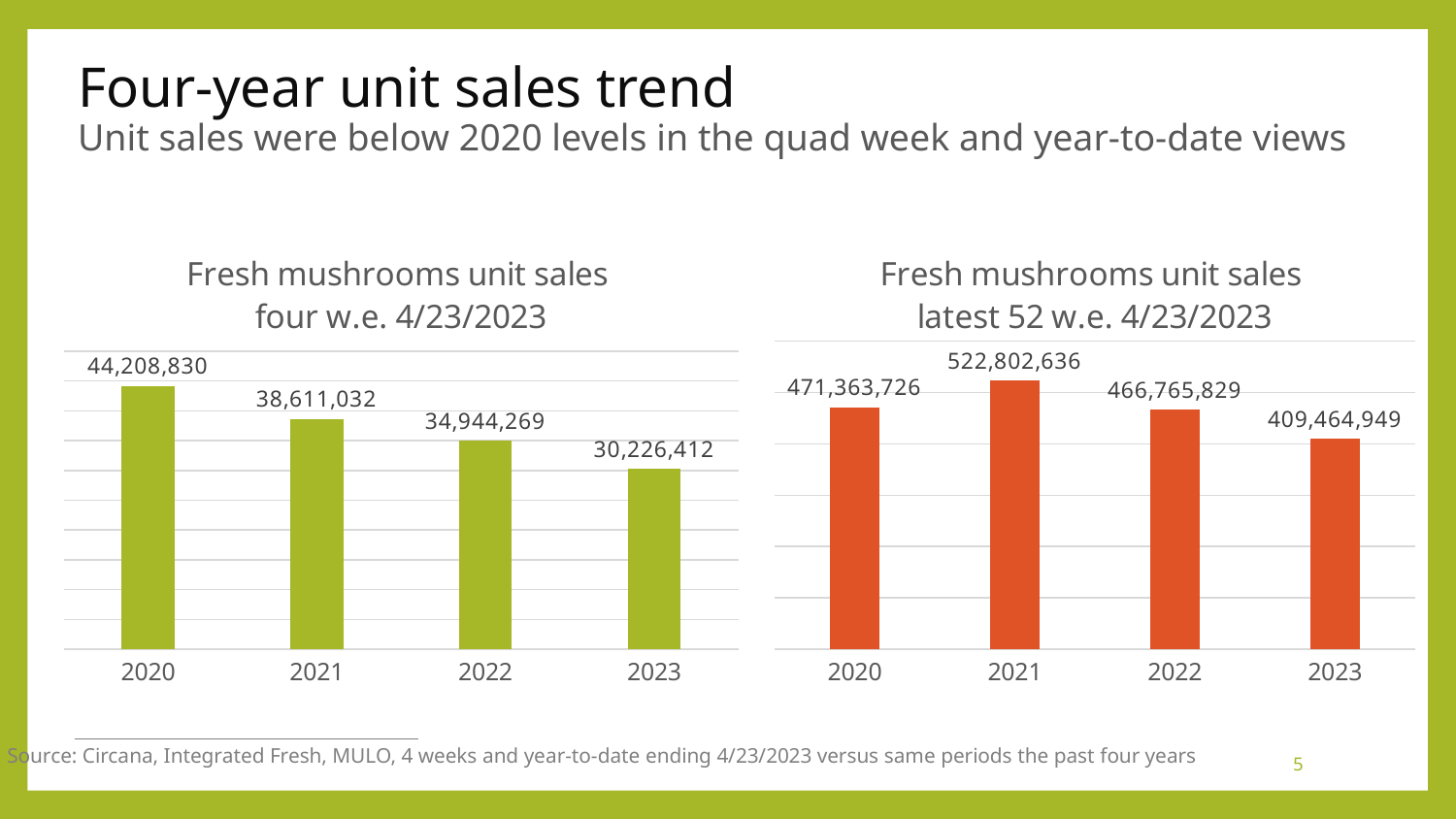
In the 'Fresh mushrooms unit sales four w.e. 4/23/2023' chart, what is the difference between the 2020 and 2023 values? 13,982,418 In the 'Fresh mushrooms unit sales latest 52 w.e. 4/23/2023' chart, what is the difference between the 2021 and 2023 values? 113,337,687 How many years are shown in the 'Fresh mushrooms unit sales four w.e. 4/23/2023' chart? 4 In the 'Fresh mushrooms unit sales latest 52 w.e. 4/23/2023' chart, what is the value for 2021? 522,802,636 In the 'Fresh mushrooms unit sales four w.e. 4/23/2023' chart, do the values rise or fall from 2020 to 2023? Fall In the 'Fresh mushrooms unit sales four w.e. 4/23/2023' chart, what is the value for 2023? 30,226,412 In the 'Fresh mushrooms unit sales four w.e. 4/23/2023' chart, which year has the lowest value? 2023 In the 'Fresh mushrooms unit sales latest 52 w.e. 4/23/2023' chart, which year has the highest value? 2021 What type of chart is the 'Fresh mushrooms unit sales latest 52 w.e. 4/23/2023' chart? Bar chart In the 'Fresh mushrooms unit sales latest 52 w.e. 4/23/2023' chart, what is the value for 2022? 466,765,829 In the 'Fresh mushrooms unit sales latest 52 w.e. 4/23/2023' chart, which is larger, the value for 2020 or the value for 2022? 2020 In the 'Fresh mushrooms unit sales four w.e. 4/23/2023' chart, what is the value for 2020? 44,208,830